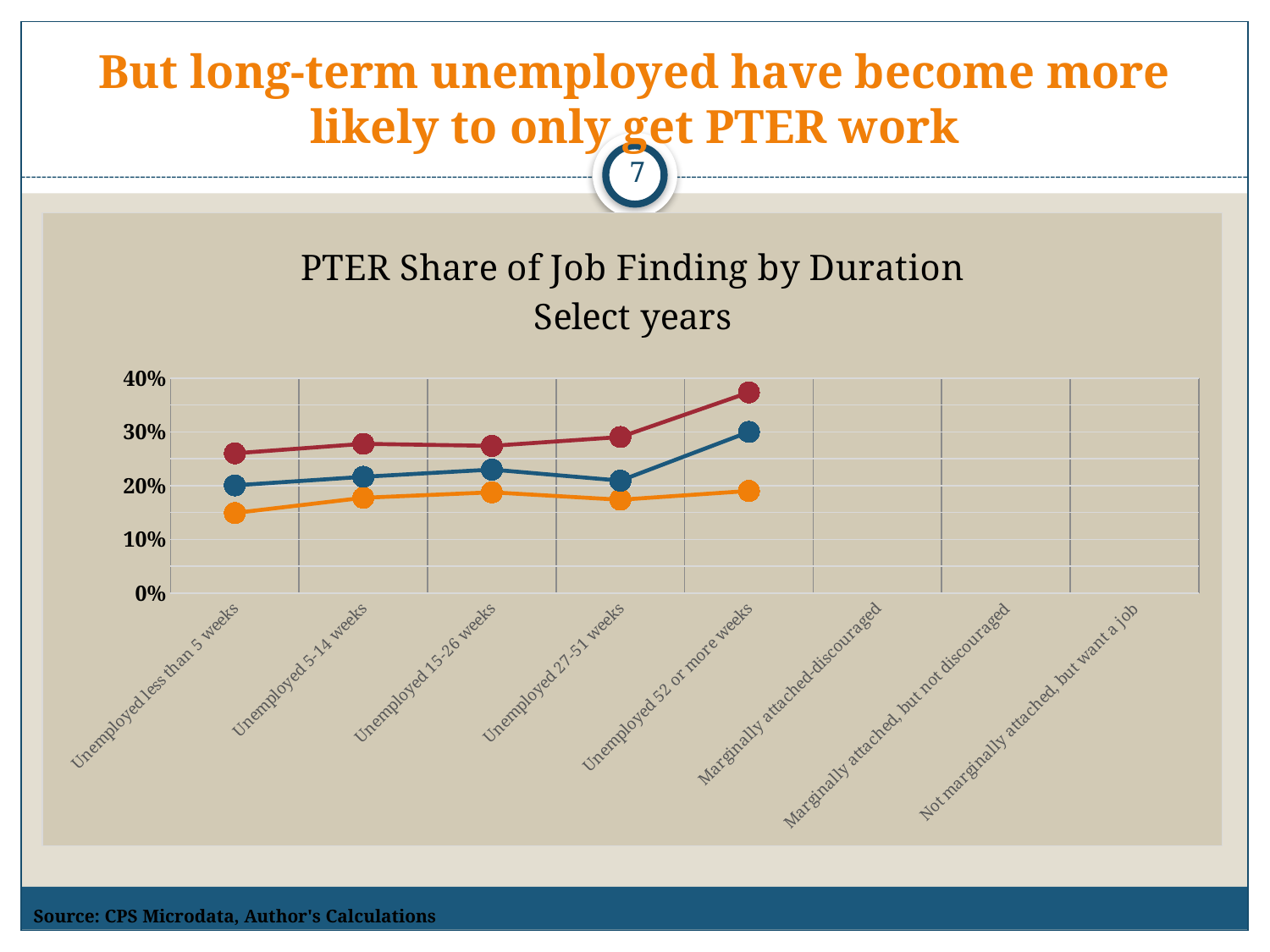
Is the value of the red line for 'Unemployed 52 or more weeks' greater or less than 30%? greater Is the value of the orange line for 'Unemployed 27-51 weeks' greater or less than 20%? less Does the red line generally rise or fall from 'Unemployed less than 5 weeks' to 'Unemployed 52 or more weeks'? rise What kind of chart is shown on the slide? line chart How many category labels appear along the x axis of the chart? 8 Is the value of the red line for 'Unemployed less than 5 weeks' greater or less than 30%? less At 'Unemployed 52 or more weeks', which line has the larger value, the red line or the orange line? red line What is the title of the chart? PTER Share of Job Finding by Duration Select years How many lines are plotted on the chart? 3 For which category does the red line reach its highest value? Unemployed 52 or more weeks How many categories on the x axis have plotted data points? 5